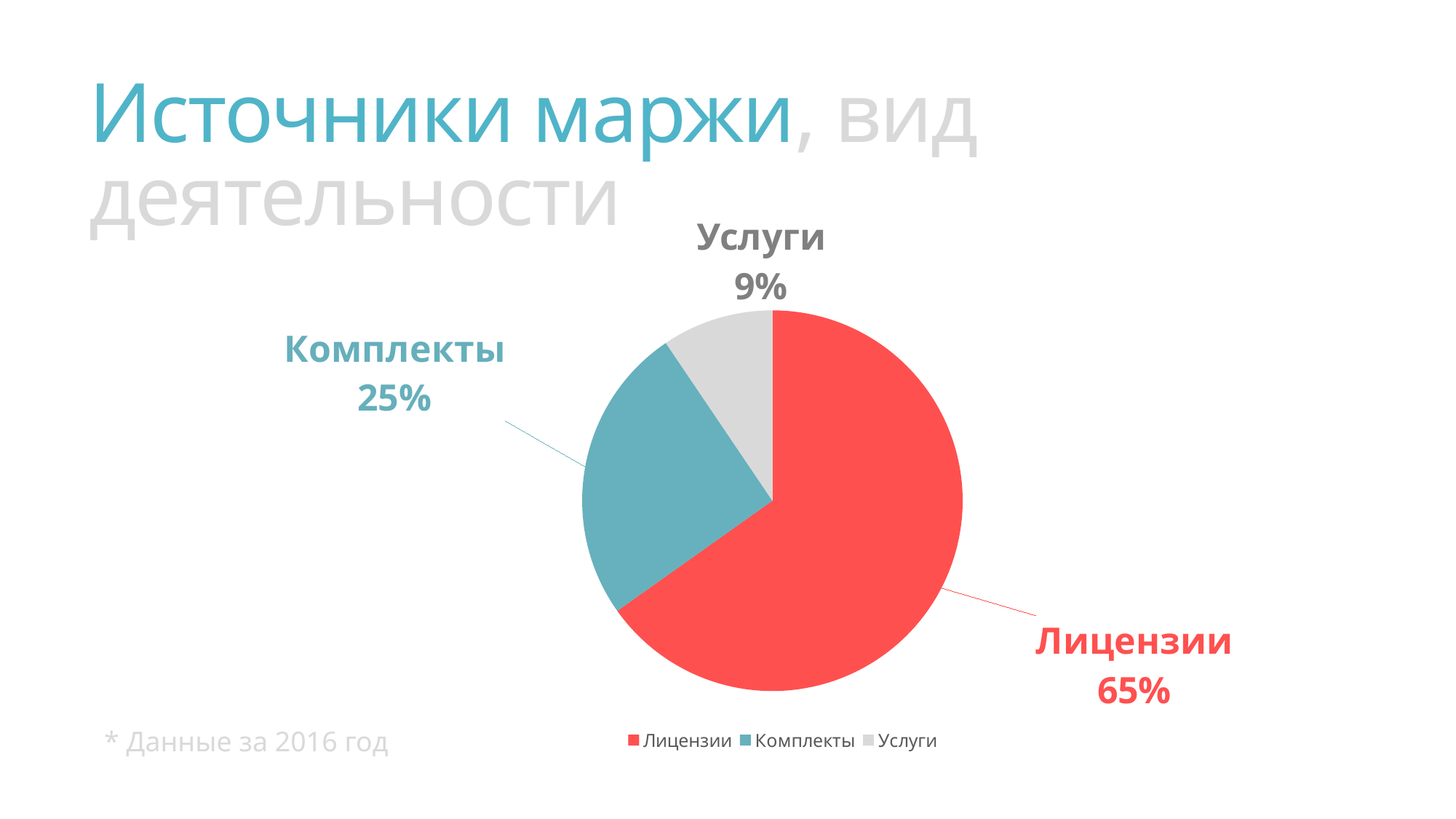
Which category has the smallest slice of the pie? Услуги What is the value shown for Услуги? 9% What is the difference in percentage points between Комплекты and Услуги? 16 How many entries does the legend list? 3 What colour is the slice for Лицензии? Red How many categories are shown in the pie chart? 3 What type of chart is shown on the slide? Pie chart Which is larger, the share for Комплекты or the share for Услуги? Комплекты What share of the pie does Лицензии account for? 65% What is the difference in percentage points between Лицензии and Комплекты? 40 Which category has the largest slice of the pie? Лицензии What is the value shown for Комплекты? 25%